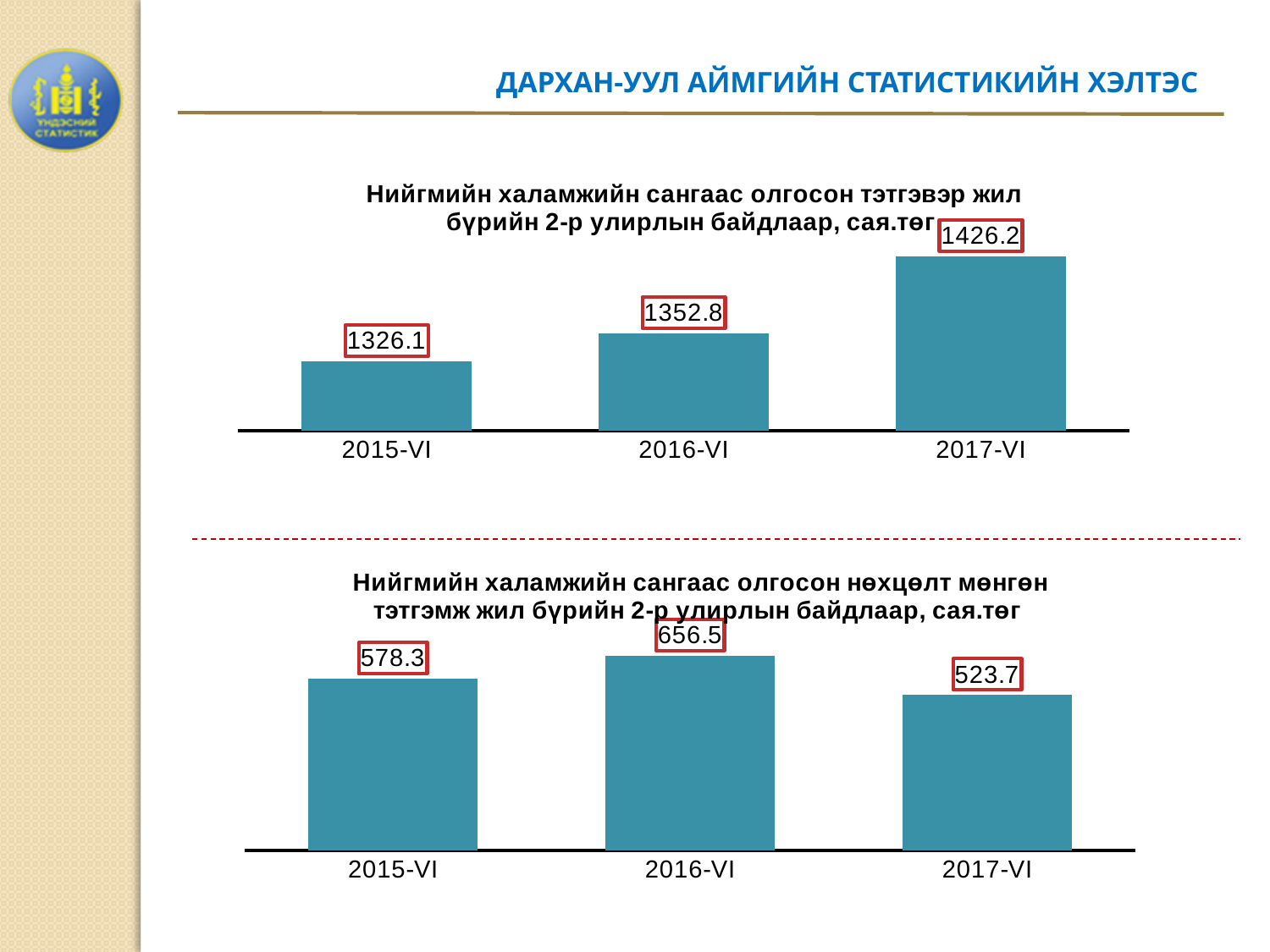
In the top chart, do the values rise or fall from 2015-VI to 2017-VI? rise In the top chart, which period has the highest value? 2017-VI In the bottom chart, what is the value for 2016-VI? 656.5 What kind of chart is the top chart? bar chart In the bottom chart, what is the difference between the 2016-VI and 2015-VI values? 78.2 In the top chart, what is the value for 2017-VI? 1426.2 In the bottom chart, which is larger, the value for 2015-VI or 2017-VI? 2015-VI In the top chart, what is the difference between the 2017-VI and 2015-VI values? 100.1 In the bottom chart, which period has the lowest value? 2017-VI In the bottom chart, what is the value for 2017-VI? 523.7 In the top chart, what is the value for 2015-VI? 1326.1 How many periods are shown in the bottom chart? 3